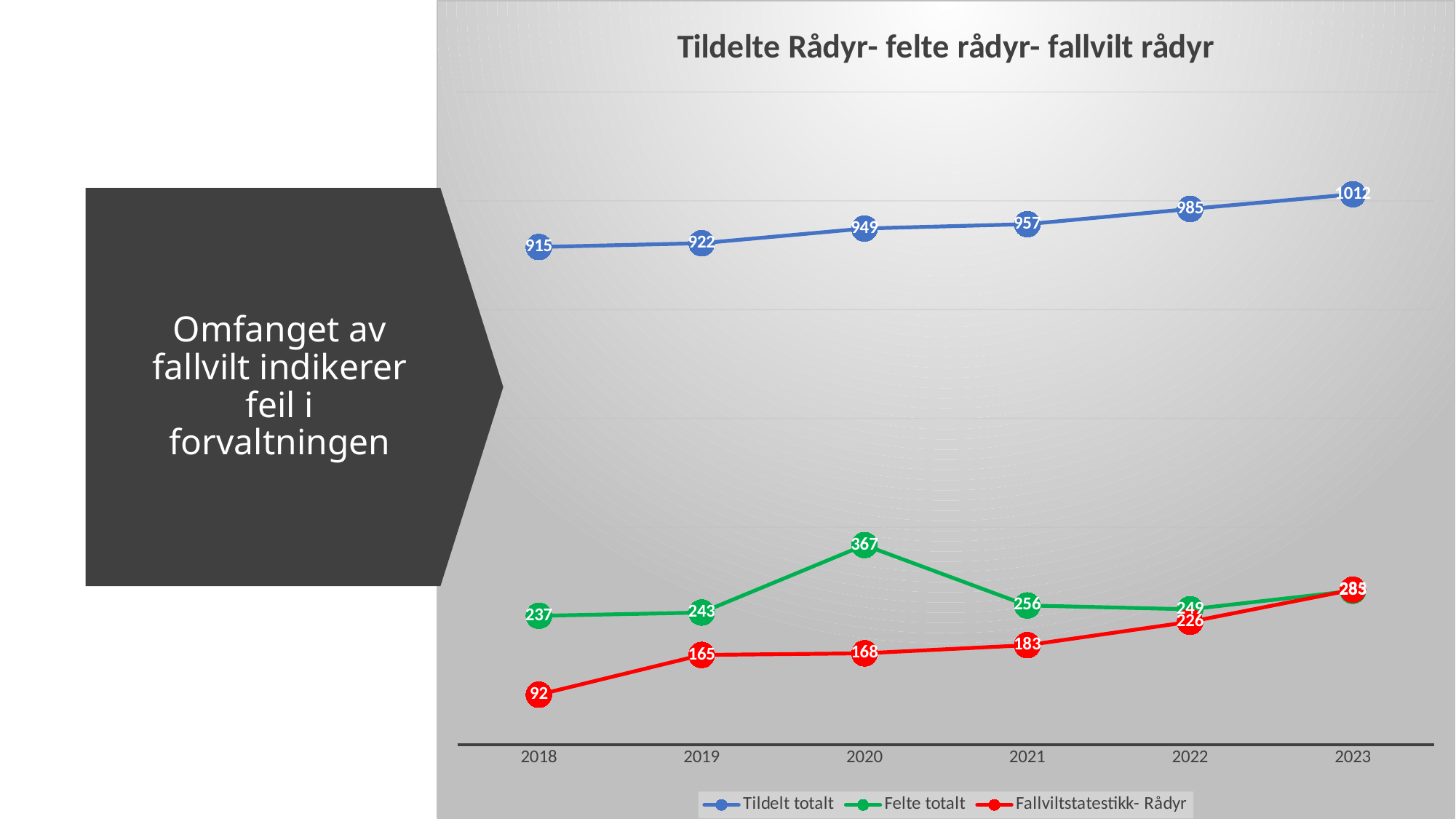
How many years are shown on the x axis? 6 What is the value of Tildelt totalt in 2023? 1012 What is the difference between Tildelt totalt in 2023 and in 2018? 97 What type of chart is shown on the slide? line chart What is the value of Fallviltstatestikk- Rådyr in 2018? 92 What is the value of Felte totalt in 2020? 367 Does Fallviltstatestikk- Rådyr rise or fall from 2018 to 2023? rise How many series does the legend list? 3 What is the value of Tildelt totalt in 2018? 915 What is the title of the chart? Tildelte Rådyr- felte rådyr- fallvilt rådyr In which year is Felte totalt highest? 2020 In which year is Fallviltstatestikk- Rådyr lowest? 2018